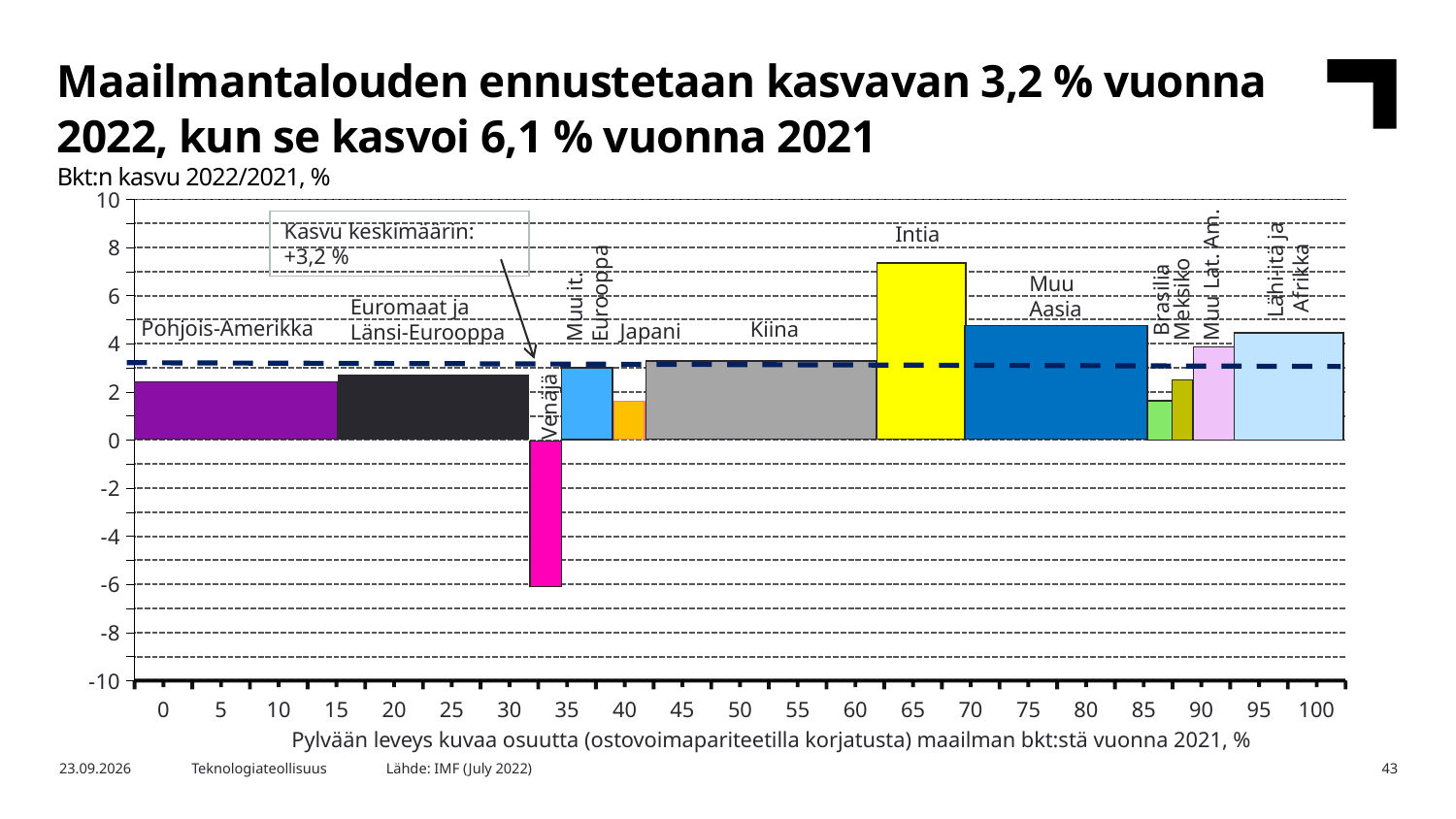
What is the average growth (Kasvu keskimäärin) shown by the dashed line in the chart? +3,2 % Is the value for Pohjois-Amerikka greater or less than 4? less Which has the higher GDP growth, Japani or Venäjä? Japani What kind of chart is shown on the slide? Bar chart Which region has the highest GDP growth in the chart? Intia Is the value for Intia greater or less than 6? greater How many regions (bars) are shown in the chart? 12 Which has the higher GDP growth, Intia or Kiina? Intia According to the note below the x axis, what does the width of each bar represent? The region's share of world GDP in 2021 (PPP-adjusted) Is the value for Muu Aasia greater or less than 4? greater Which region has the lowest GDP growth in the chart? Venäjä